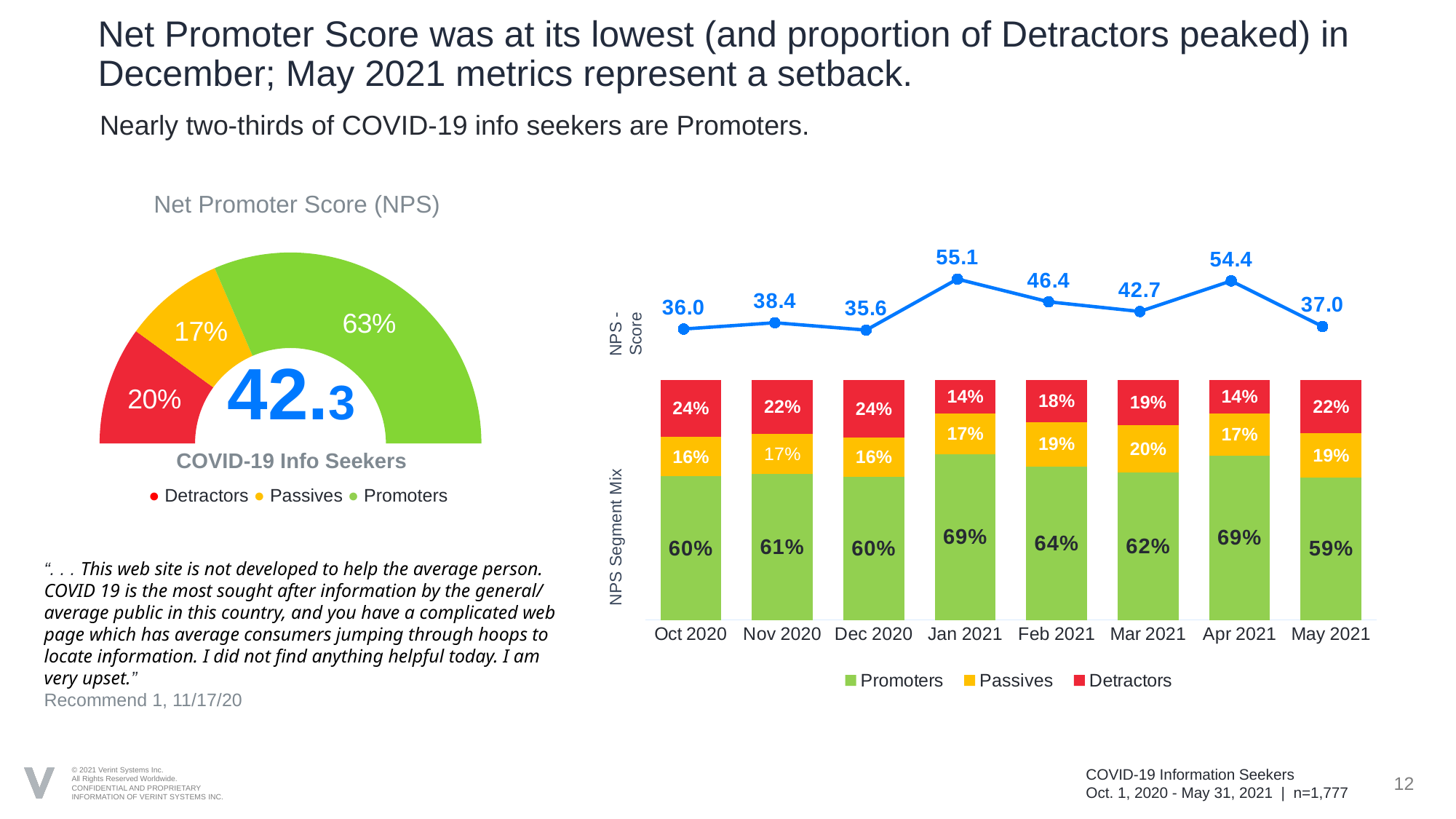
In the NPS Segment Mix stacked bar chart on the right, what is the Detractors percentage for Dec 2020? 24% In the NPS Segment Mix stacked bar chart on the right, what percentage of May 2021 respondents are Promoters? 59% In the NPS - Score line chart on the right, which month has the highest NPS score? Jan 2021 In the Net Promoter Score (NPS) gauge chart on the left, what percentage are Detractors? 20% In the NPS Segment Mix stacked bar chart on the right, how many series does the legend list? 3 In the NPS - Score line chart on the right, what is the NPS score for Apr 2021? 54.4 In the NPS - Score line chart on the right, what is the difference between the Jan 2021 score and the May 2021 score? 18.1 In the NPS Segment Mix stacked bar chart on the right, how many months are shown on the x axis? 8 In the Net Promoter Score (NPS) gauge chart on the left, what percentage of COVID-19 Info Seekers are Promoters? 63% In the NPS - Score line chart on the right, which month has the lowest NPS score? Dec 2020 What kind of chart is the NPS - Score chart on the right? Line chart In the NPS Segment Mix stacked bar chart on the right, which month has the larger Passives percentage, Feb 2021 or Mar 2021? Mar 2021